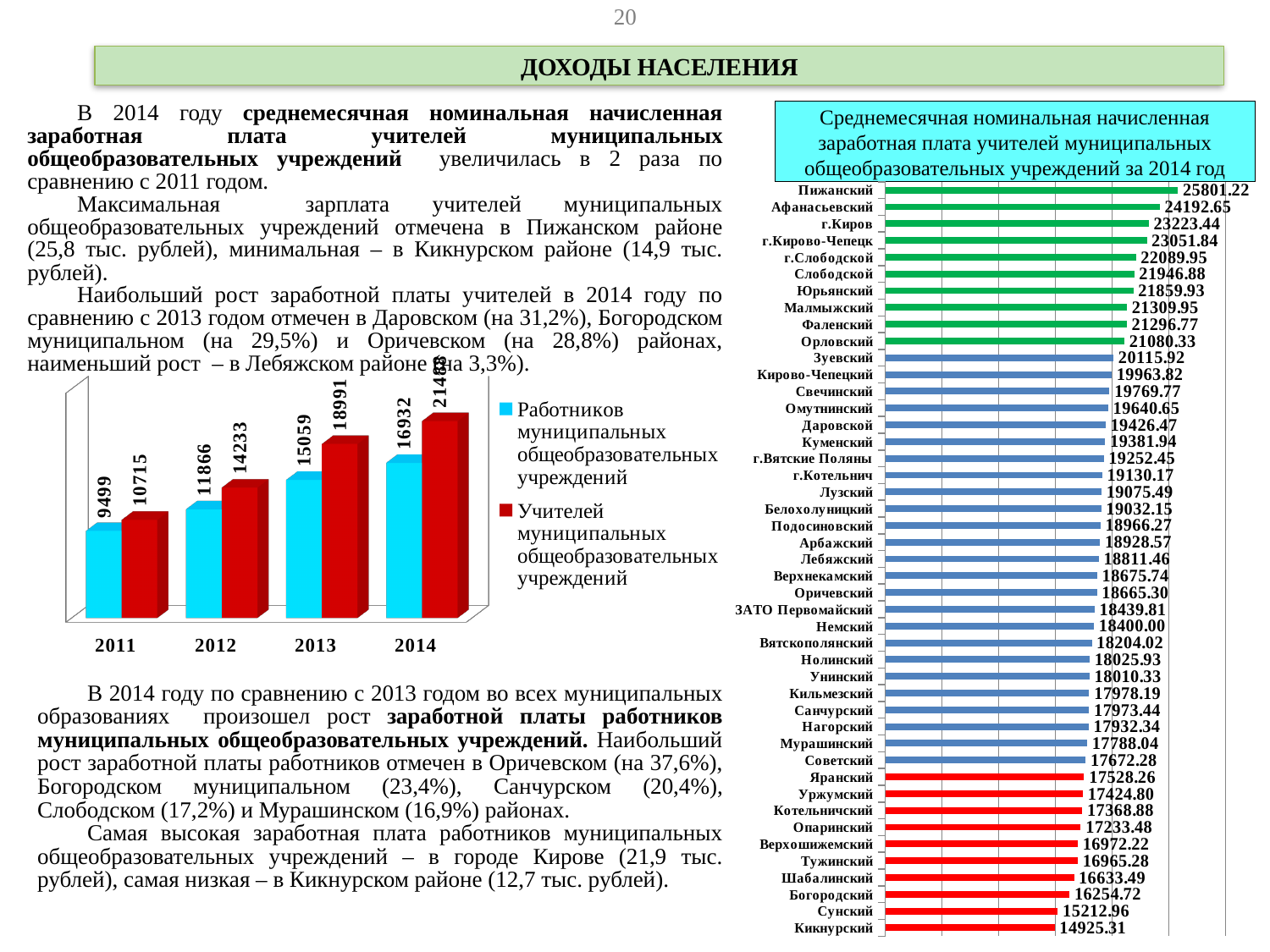
On the right chart, which district has the lowest value? Кикнурский On the right chart, what is the value for Даровской? 19426.47 On the right chart, what is the difference between the values for Пижанский and Кикнурский? 10875.91 On the right chart, which is larger: the value for Оричевский or the value for Яранский? Оричевский How many districts are shown on the right chart? 45 On the right chart, what is the value for Богородский? 16254.72 On the right chart, what is the value for г.Киров? 23223.44 On the left chart, what is the difference between the two series' values in 2013? 3932 What kind of chart is the chart on the left of the slide (years 2011–2014)? bar chart On the right chart (Среднемесячная номинальная начисленная заработная плата учителей ... за 2014 год), which district has the highest value? Пижанский On the left chart, do the values for Работников муниципальных общеобразовательных учреждений rise or fall from 2011 to 2014? rise On the left chart, what is the value for Учителей муниципальных общеобразовательных учреждений in 2013? 18991